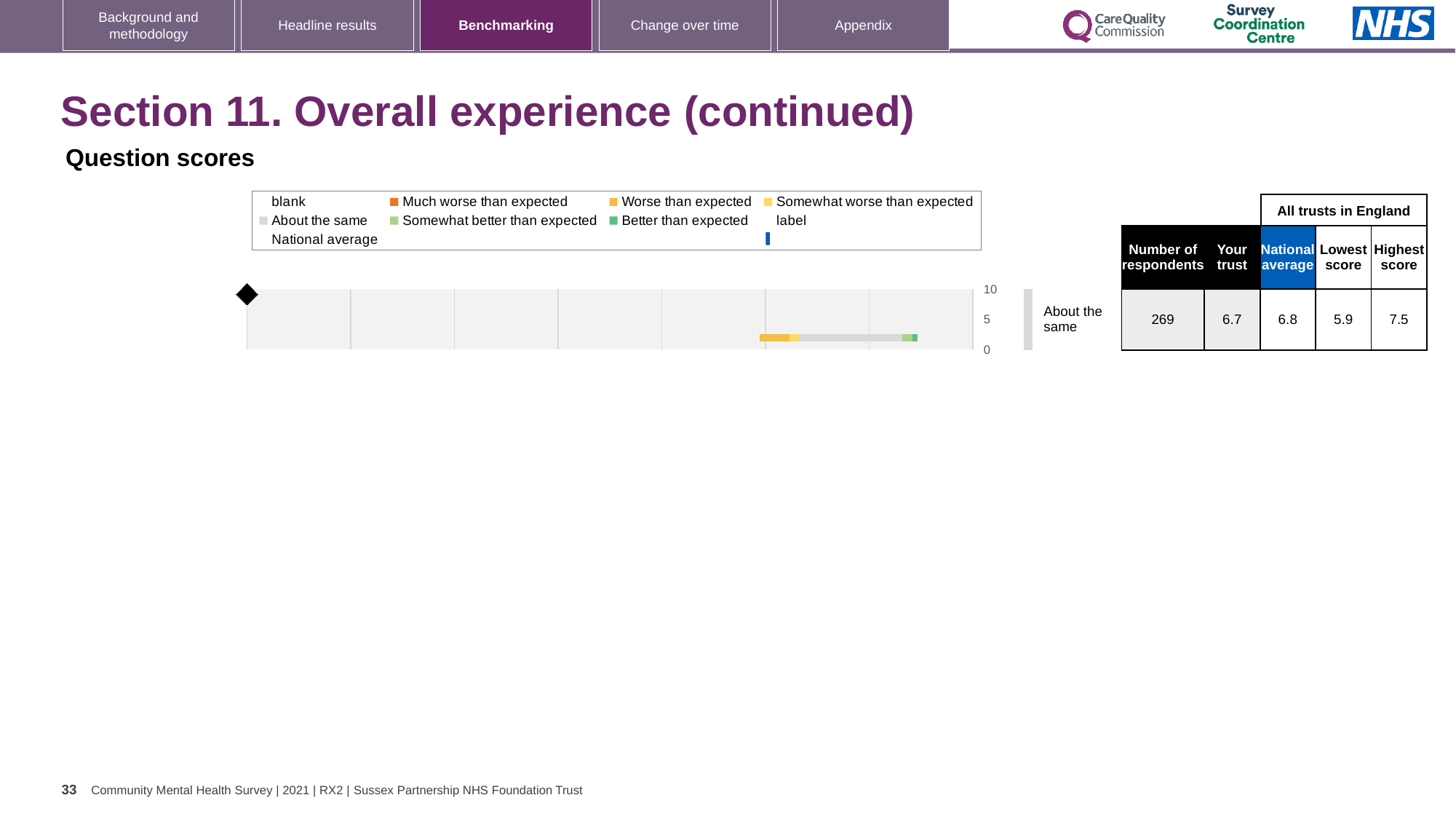
How many respondents are shown for the 'About the same' question? 269 What kind of chart is shown on the slide? bar chart Which is larger for this question, the 'Your trust' score or the national average? National average What is the lowest score among all trusts in England for this question? 5.9 By how much does the national average exceed the 'Your trust' score? 0.1 What is the national average score shown for the 'About the same' question? 6.8 What is the highest score among all trusts in England for this question? 7.5 Is the 'Your trust' score for this question greater or less than 5? greater What is the maximum value shown on the chart's score axis? 10 What is the difference between the highest score and the lowest score for this question? 1.6 What is the 'Your trust' score for the 'About the same' question? 6.7 How many question categories are plotted in the chart? 1